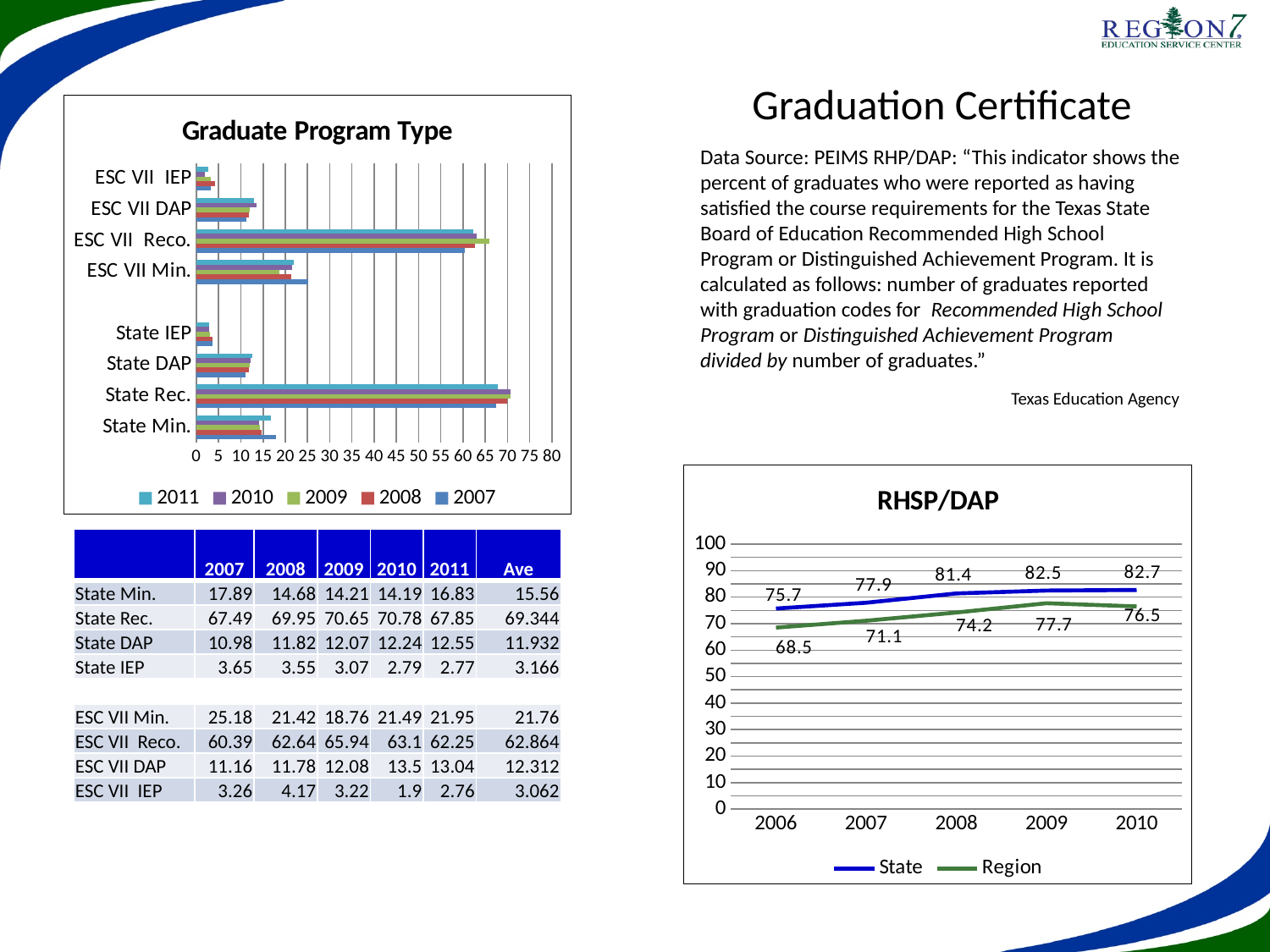
In the RHSP/DAP chart, which year has the lowest Region value? 2006 What kind of chart is the Graduate Program Type chart? bar chart In the RHSP/DAP chart, what is the State value for 2008? 81.4 In the RHSP/DAP chart, which series has the larger value in 2010, State or Region? State In the RHSP/DAP chart, what is the Region value for 2009? 77.7 In the Graduate Program Type chart, how many series does the legend list? 5 In the RHSP/DAP chart, how many series does the legend list? 2 In the RHSP/DAP chart, how many years are plotted on the x axis? 5 In the RHSP/DAP chart, does the State line rise or fall from 2006 to 2010? rise In the Graduate Program Type chart, is the 2011 value for State Rec. greater or less than 60? greater In the RHSP/DAP chart, which year has the highest State value? 2010 In the RHSP/DAP chart, what is the difference between the State and Region values in 2006? 7.2